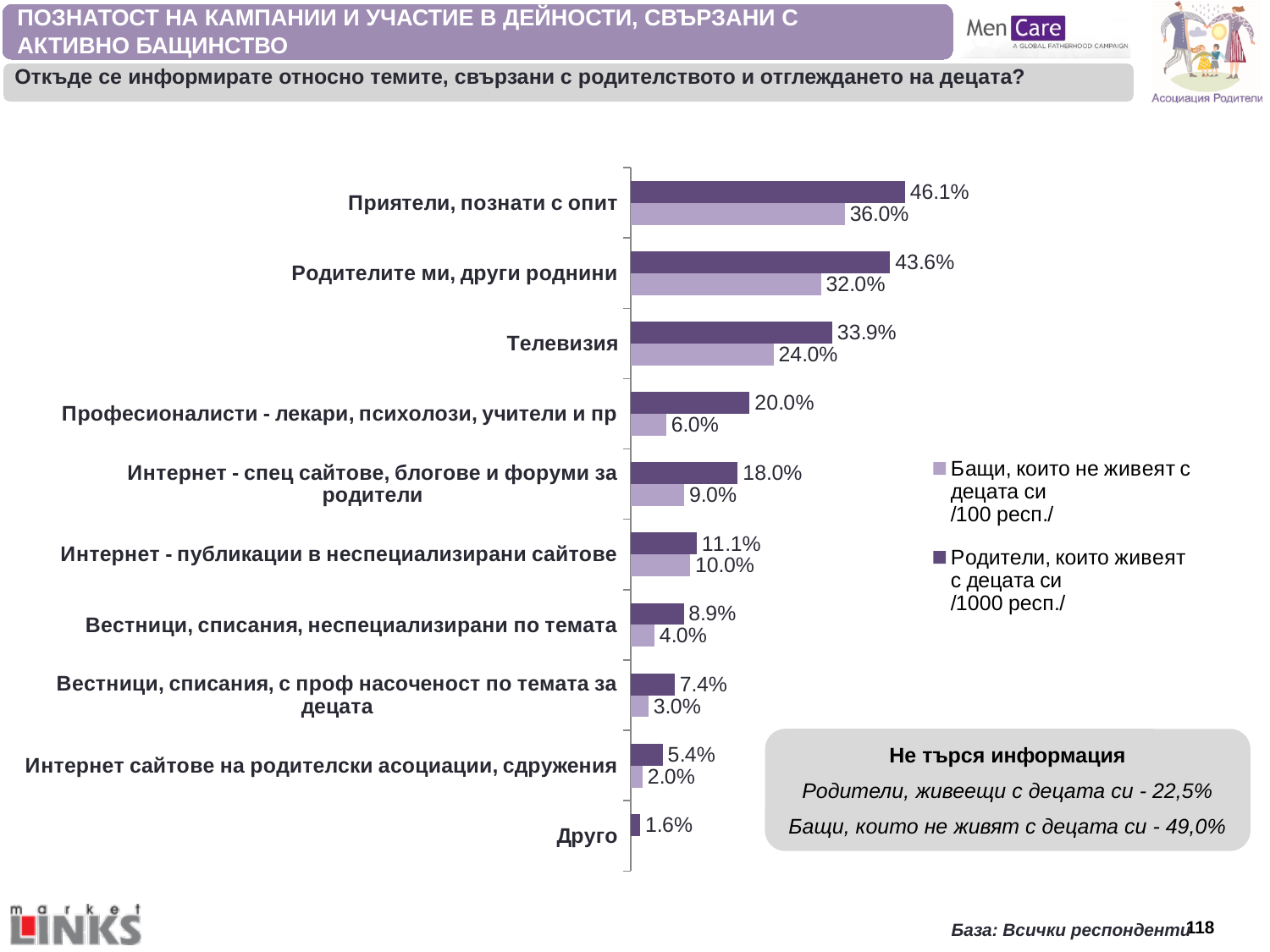
Which colour represents the series "Бащи, които не живеят с децата си" in the legend? light purple What is the value for "Професионалисти - лекари, психолози, учители и пр" for the series "Бащи, които не живеят с децата си"? 6.0% What is the value for "Приятели, познати с опит" for the series "Бащи, които не живеят с децата си"? 36.0% For "Интернет - публикации в неспециализирани сайтове", which series has the larger value? Родители, които живеят с децата си What is the value for "Телевизия" for the series "Родители, които живеят с децата си"? 33.9% What is the difference between the two series for "Родителите ми, други роднини"? 11.6% Which category has the highest value for the series "Родители, които живеят с децата си"? Приятели, познати с опит What type of chart is shown on the slide? bar chart Which category has the lowest value for the series "Бащи, които не живеят с децата си"? Интернет сайтове на родителски асоциации, сдружения What is the value for "Друго" for the series "Родители, които живеят с децата си"? 1.6% How many categories are shown on the chart? 10 How many series does the legend list? 2